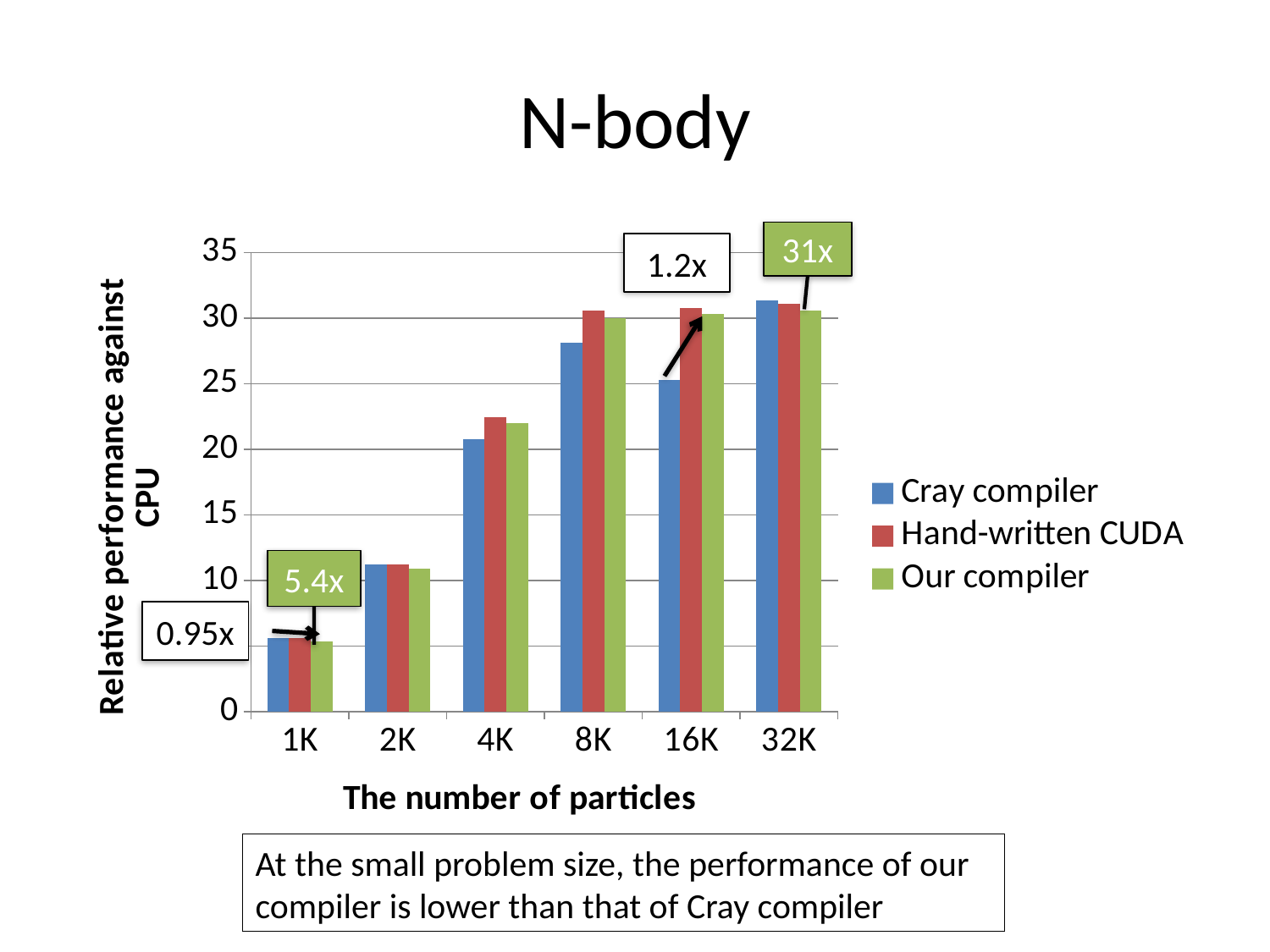
How many series does the legend list? 3 At 16K particles, which is larger: Cray compiler or Hand-written CUDA? Hand-written CUDA What kind of chart is shown on the slide? Bar chart For the Our compiler series, which number of particles has the lowest relative performance? 1K How many particle-count categories are shown on the x axis? 6 Is the value for Cray compiler at 16K greater or less than 30? less At 4K particles, which is larger: Cray compiler or Our compiler? Our compiler What is the title of the x axis? The number of particles Is the value for Hand-written CUDA at 8K greater or less than 25? greater Do the Hand-written CUDA values rise or fall from 1K to 8K particles? rise For the Cray compiler series, which number of particles has the highest relative performance? 32K Is the value for Our compiler at 4K greater or less than 20? greater